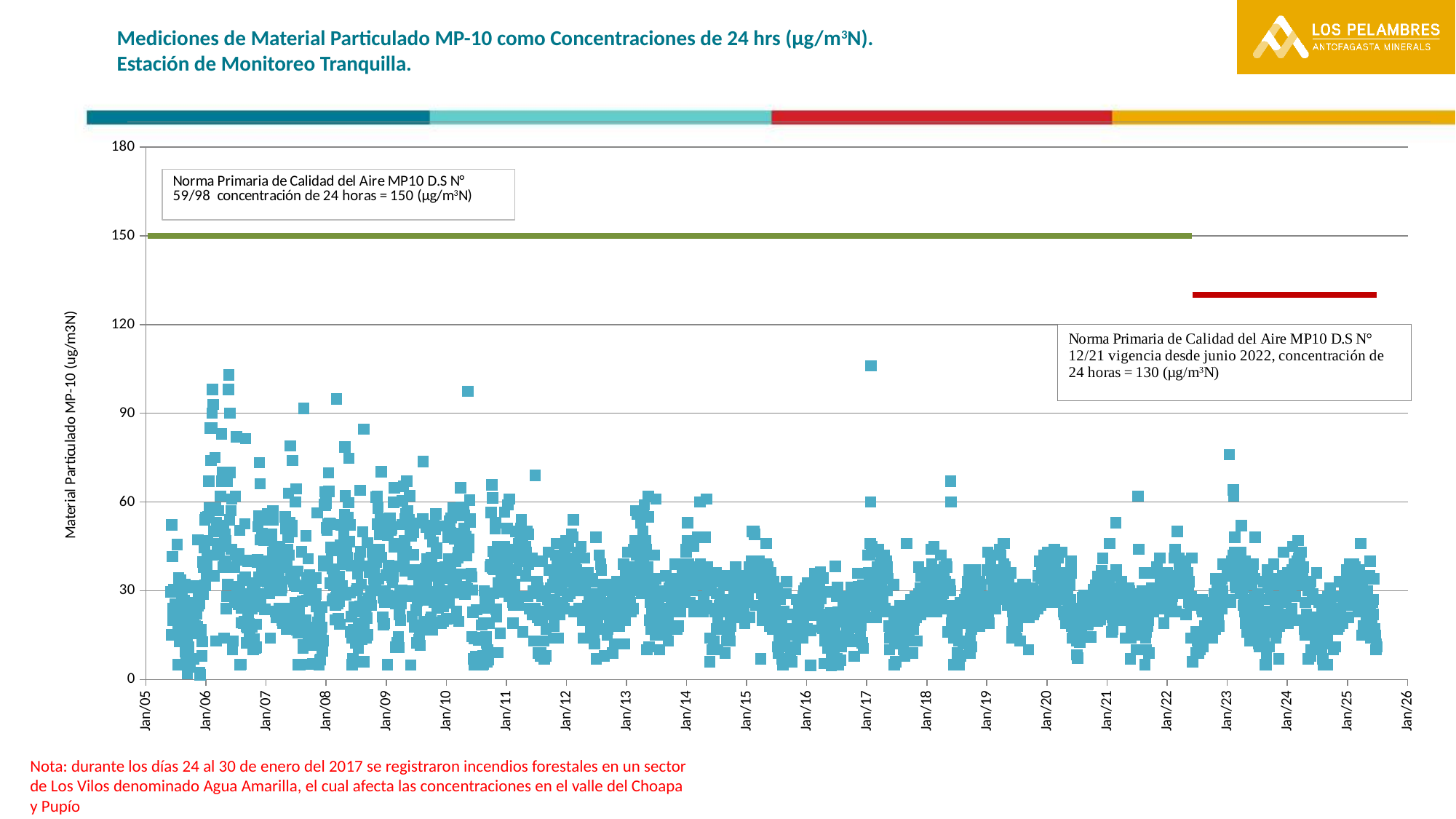
Is the highest measurement plotted near Jan/17 greater or less than 120? less Which monitoring station does the chart title refer to? Estación de Monitoreo Tranquilla Do any plotted measurements exceed the 150 norm line? No What is the maximum value shown on the y axis? 180 Since when is the D.S N° 12/21 norm in force, according to the slide? junio 2022 What is the 24-hour concentration limit set by Norma Primaria de Calidad del Aire MP10 D.S N° 59/98, as stated on the slide? 150 (µg/m³N) Is the highest measurement plotted near Jan/17 greater or less than 90? greater Which is larger: the highest measurement near Jan/17 or the highest measurement near Jan/23? Jan/17 How many year labels (Jan/05 through Jan/26) are shown on the x axis? 22 What kind of chart is shown on the slide? Scatter chart What is the 24-hour concentration limit set by Norma Primaria de Calidad del Aire MP10 D.S N° 12/21, as stated on the slide? 130 (µg/m³N)